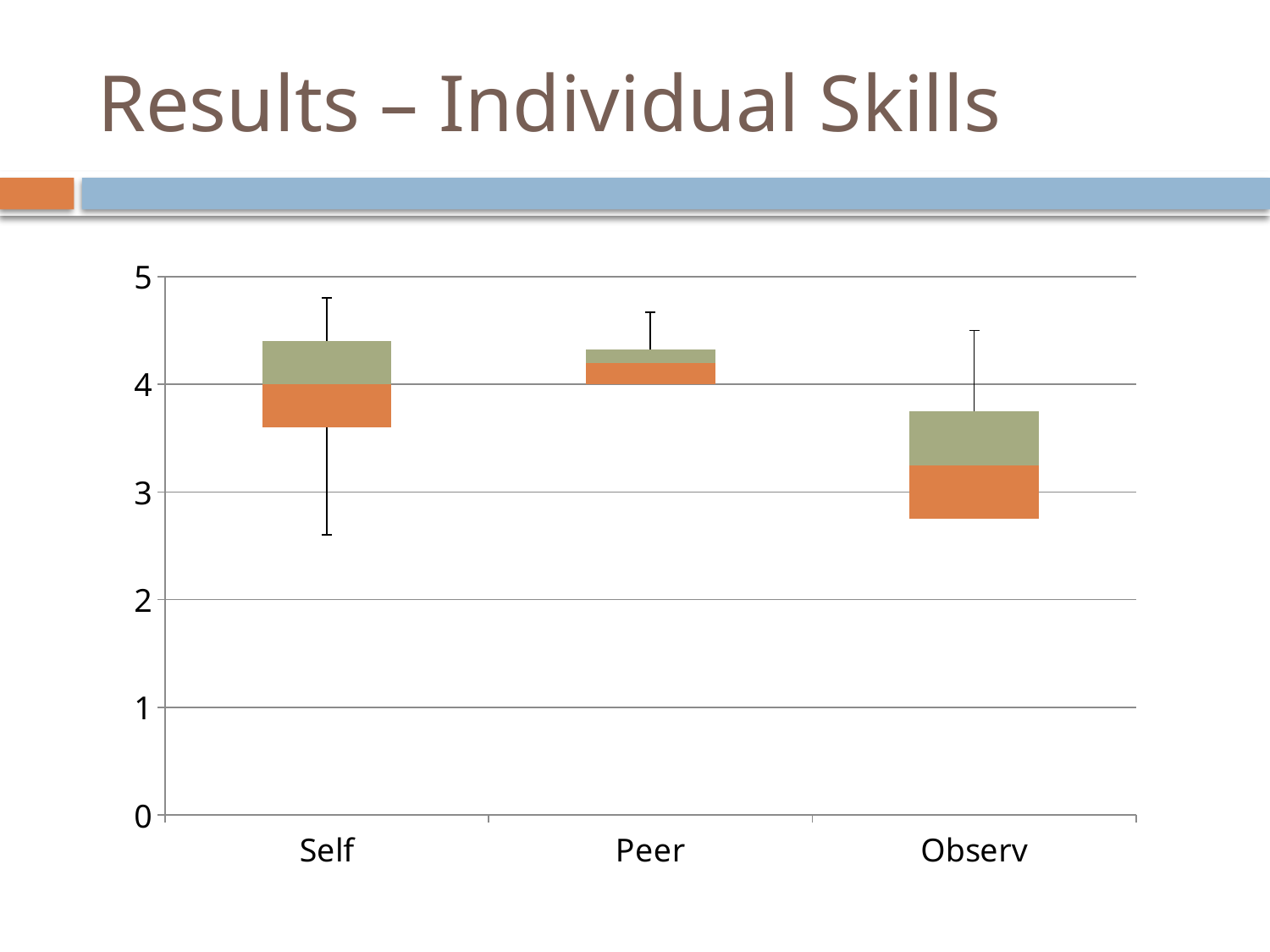
Which category has the narrowest (shortest) box? Peer What is the highest value shown on the y axis? 5 What kind of chart is shown on the slide? box-and-whisker (box plot) chart How many categories are shown on the x axis? 3 Is the bottom of the box for Self greater or less than 4? less Is the top of the box for Self greater or less than 4? greater Is the lower whisker end for Self greater or less than 3? less Which category has the lowest box on the chart? Observ What is the title of the slide containing the chart? Results – Individual Skills